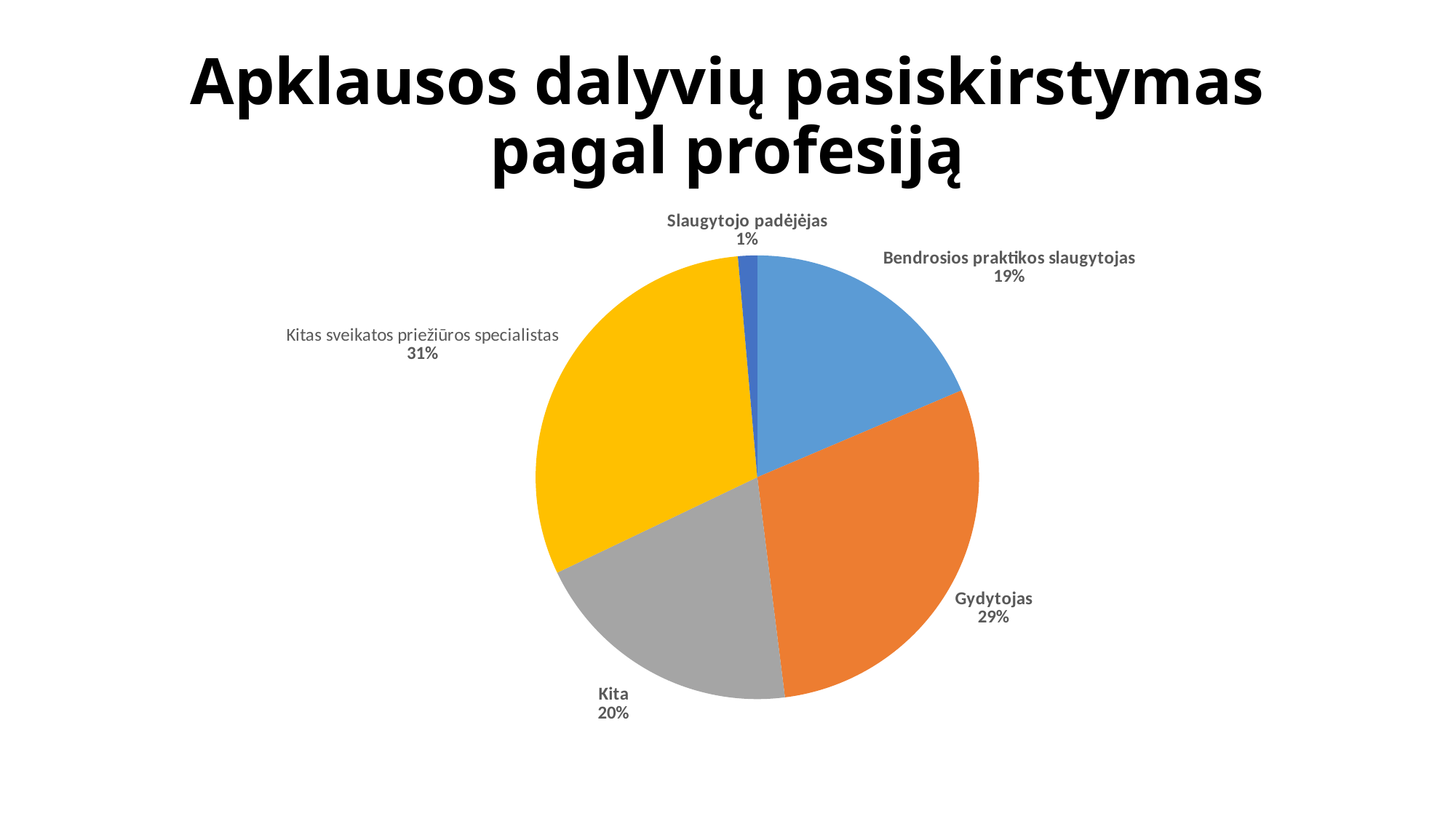
What share of survey participants are Gydytojas? 29% What percentage is shown for Kitas sveikatos priežiūros specialistas? 31% Which is larger, the share for Kita or the share for Bendrosios praktikos slaugytojas? Kita What is the title of the slide? Apklausos dalyvių pasiskirstymas pagal profesiją Which category has the smallest share of the pie? Slaugytojo padėjėjas What percentage is shown for Bendrosios praktikos slaugytojas? 19% What percentage is shown for Slaugytojo padėjėjas? 1% Which category has the largest share of the pie? Kitas sveikatos priežiūros specialistas What is the difference in percentage points between Gydytojas and Bendrosios praktikos slaugytojas? 10 What percentage is shown for Kita? 20% How many categories are shown in the pie chart? 5 What kind of chart is shown on the slide? pie chart